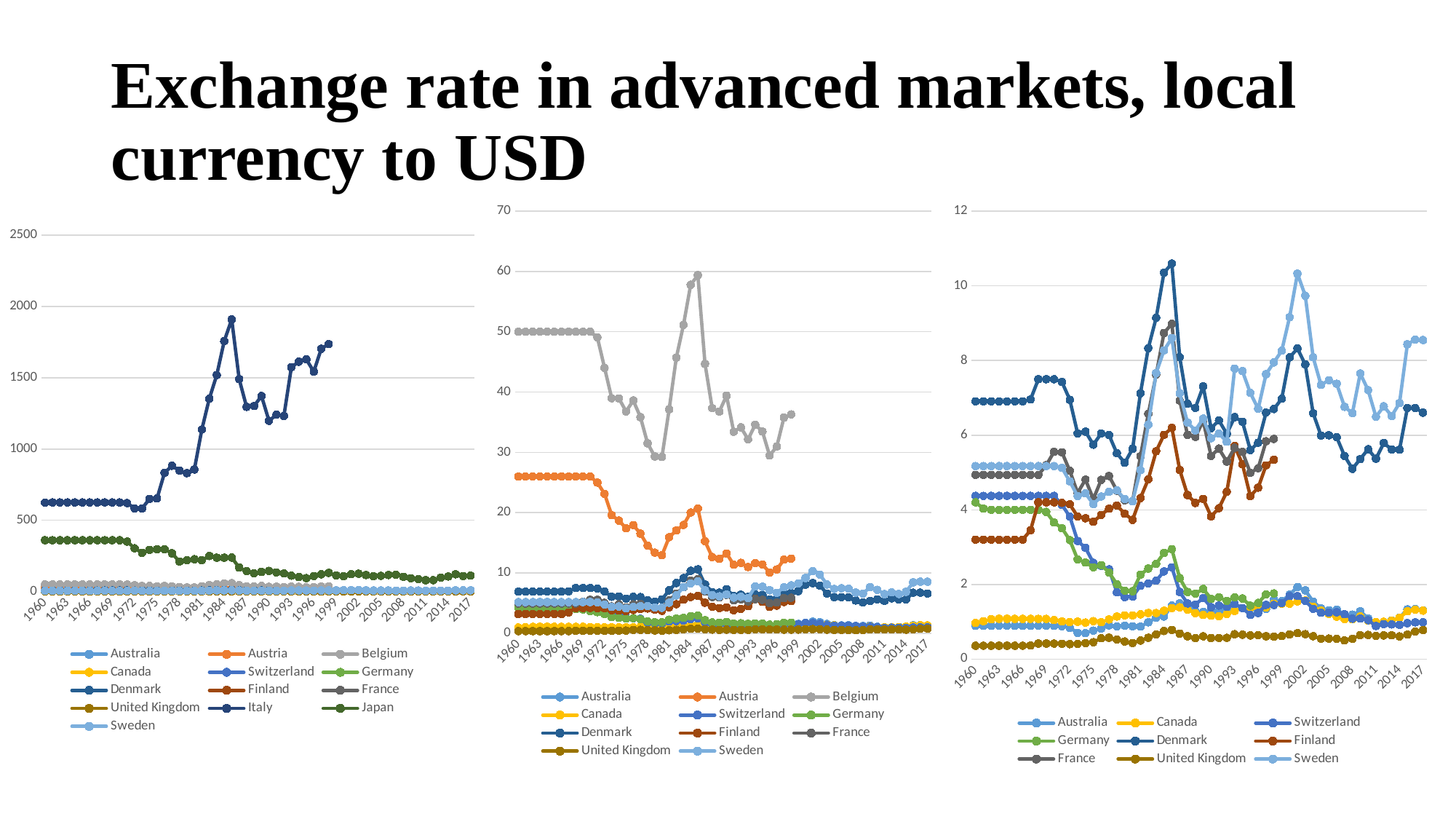
In the right chart, does the United Kingdom line rise or fall from 1960 to 2017? rise How many series does the legend of the middle chart list? 11 In the right chart, is the value for Sweden in 2002 greater or less than 10? less In the left chart, which series reaches the highest value? Italy In the left chart, is the value for Japan in 1960 greater or less than 500? less What kind of chart is the left chart on the slide? line chart What is the title of the slide? Exchange rate in advanced markets, local currency to USD In the middle chart, which series has the highest values? Belgium In the left chart, does the Japan line rise or fall from 1960 to 2017? fall How many series does the legend of the right chart list? 9 How many series does the legend of the left chart list? 13 In the left chart, is the value for Italy in 1984 greater or less than 1500? greater